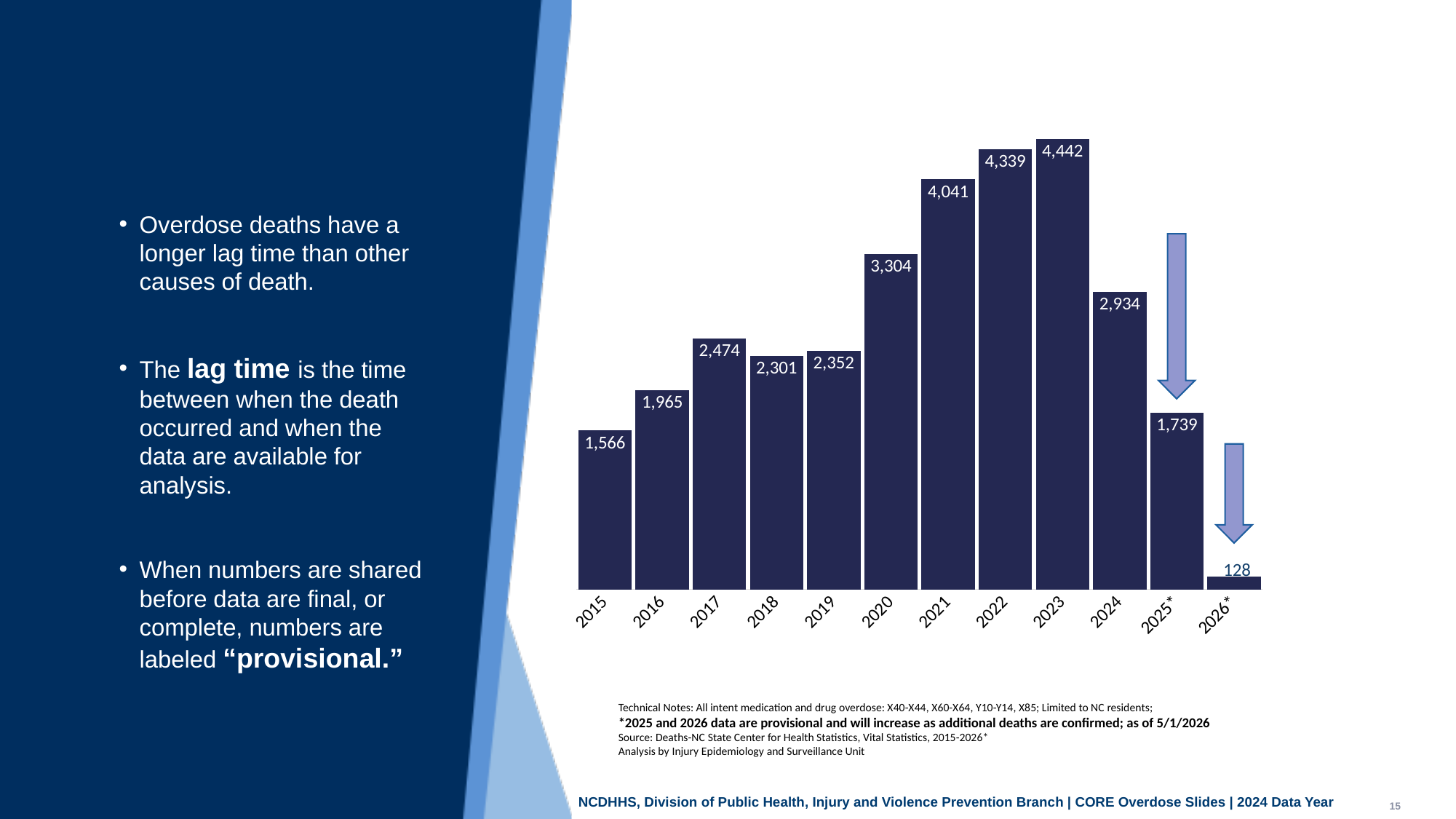
Do the values rise or fall from 2019 to 2023? Rise Which years are marked with an asterisk as provisional? 2025 and 2026 Which year has the highest value? 2023 Which is larger, the value for 2018 or the value for 2019? 2019 Which year has the lowest value? 2026* What kind of chart is shown? Bar chart How many years are shown on the x axis? 12 What is the value shown for 2015? 1,566 What is the difference between the values for 2023 and 2024? 1,508 What is the difference between the values for 2020 and 2021? 737 What is the value shown for 2025*? 1,739 What is the value shown for 2023? 4,442